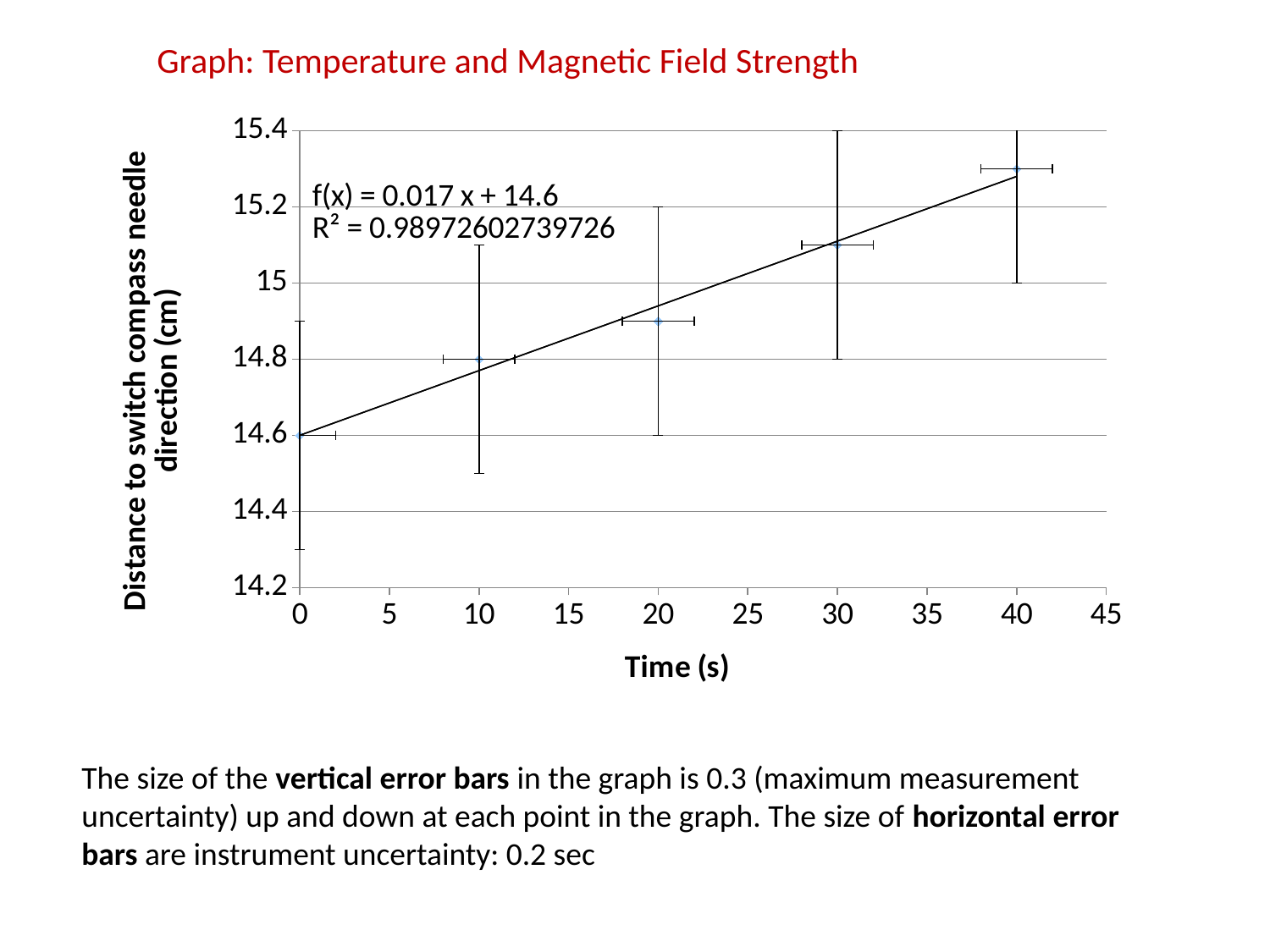
Is the value at 30 s greater or less than 15? greater Is the value at 20 s greater or less than 15? less At which time is the plotted distance lowest? 0 s How many data points are plotted on the chart? 5 What kind of chart is shown on the slide? scatter chart At which time is the plotted distance highest? 40 s Is the value at 40 s greater or less than 15.2? greater Which has the larger distance value, the point at 30 s or the point at 20 s? 30 s What is the distance value at time 0 s? 14.6 Do the plotted values rise or fall as time increases? rise What is the distance value at time 10 s? 14.8 What is the trendline equation shown on the chart? f(x) = 0.017 x + 14.6